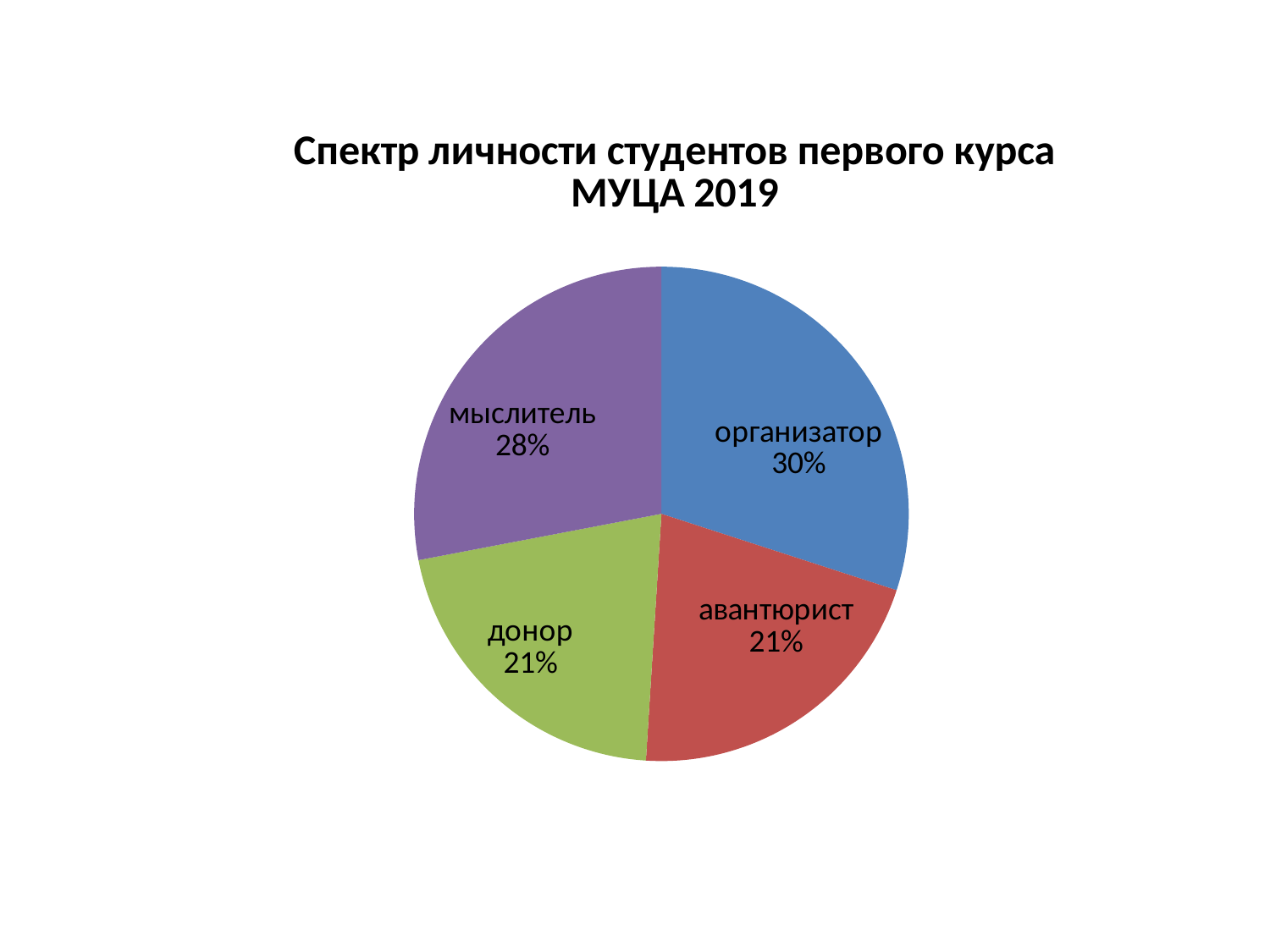
What is the title of the chart? Спектр личности студентов первого курса МУЦА 2019 What is the difference in percentage points between "организатор" and "мыслитель"? 2 What share of the pie does the "авантюрист" slice represent? 21% What share of the pie does the "организатор" slice represent? 30% What share of the pie does the "донор" slice represent? 21% Which category has the largest slice of the pie? организатор How many slices does the pie chart have? 4 What is the difference in percentage points between "организатор" and "донор"? 9 What colour is the "донор" slice? green Which is larger, the share for "мыслитель" or the share for "авантюрист"? мыслитель What kind of chart is shown on the slide? pie chart